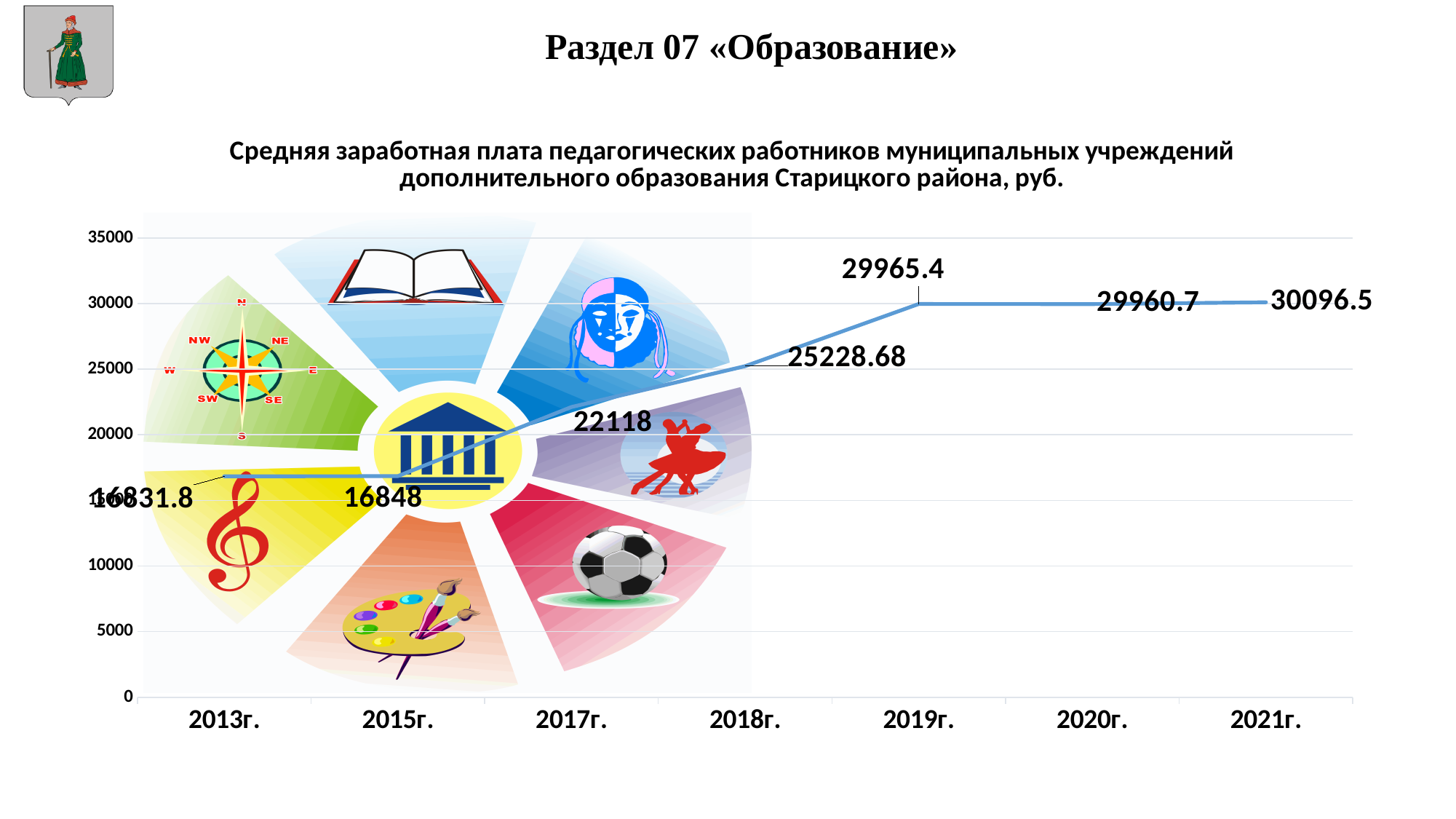
Which year has the highest value? 2021г. Is the value for 2013г. greater or less than 15000? greater What kind of chart is shown on the slide? line chart How many years are plotted on the chart? 7 Which is larger, the value for 2019г. or the value for 2020г.? 2019г. What is the difference between the values for 2019г. and 2018г.? 4736.72 What is the value for 2018г.? 25228.68 What is the difference between the values for 2021г. and 2020г.? 135.8 What is the value for 2019г.? 29965.4 What is the value for 2021г.? 30096.5 What is the value for 2017г.? 22118 What is the value for 2015г.? 16848